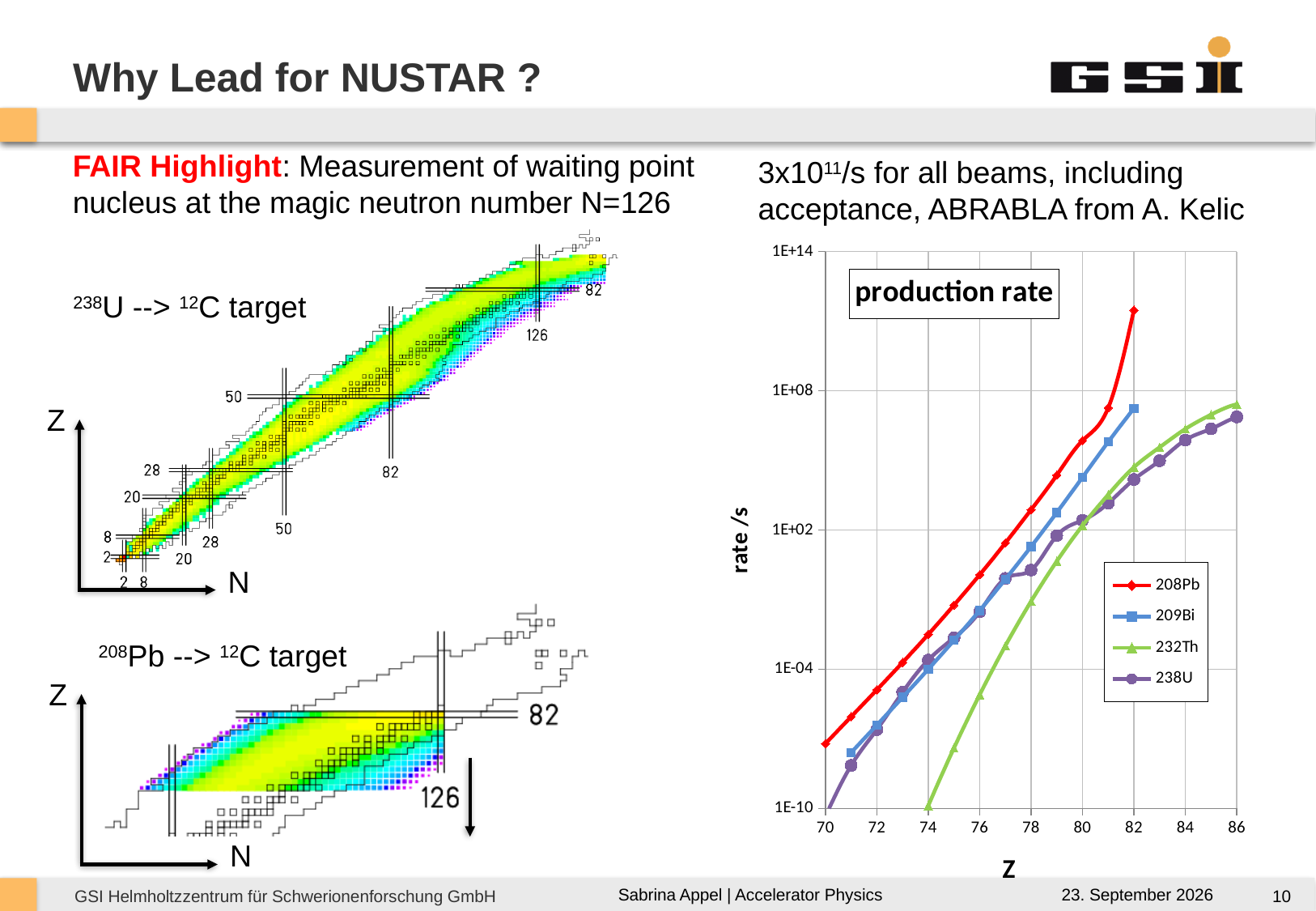
In the 'production rate' chart, does the rate for 209Bi rise or fall as Z increases? rise In the 'production rate' chart, at Z=82, which series has the larger rate, 208Pb or 209Bi? 208Pb What is the title of the chart on the right of the slide? production rate In the 'production rate' chart, is the rate for 208Pb at Z=70 greater or less than 1E-04? less In the 'production rate' chart, is the rate for 232Th at Z=78 greater or less than 1E+02? less What is the y-axis label of the 'production rate' chart? rate /s How many series does the legend of the 'production rate' chart list? 4 In the 'production rate' chart, is the rate for 208Pb at Z=82 greater or less than 1E+08? greater In the 'production rate' chart, at Z=74, which series has the larger rate, 238U or 232Th? 238U In the 'production rate' chart, which series has the lowest rate at Z=74? 232Th What kind of chart is the 'production rate' chart? line chart In the 'production rate' chart, which series reaches the highest rate at Z=82? 208Pb